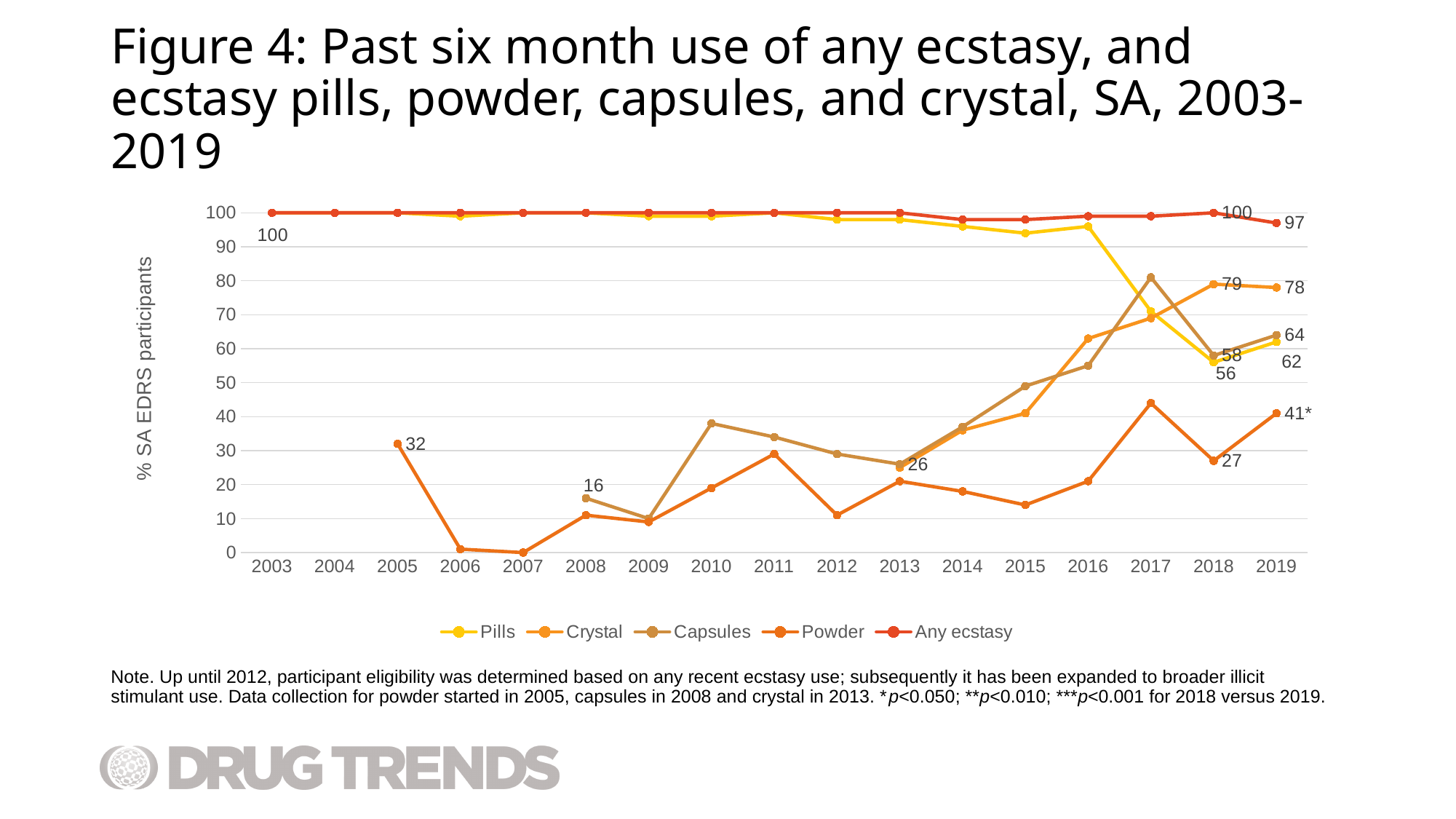
What is the label on the y axis? % SA EDRS participants What is the value for Any ecstasy in 2019? 97 What is the value for Capsules in 2008? 16 How many series does the legend list? 5 Is the value for Capsules in 2017 greater or less than 70? greater What is the value for Crystal in 2019? 78 How many years are shown along the x axis? 17 What is the difference between the Powder values for 2019 and 2018? 14 Which series has the highest value in 2019? Any ecstasy What is the value for Powder in 2005? 32 What is the difference between the Pills values for 2019 and 2018? 6 What kind of chart is shown on the slide? line chart